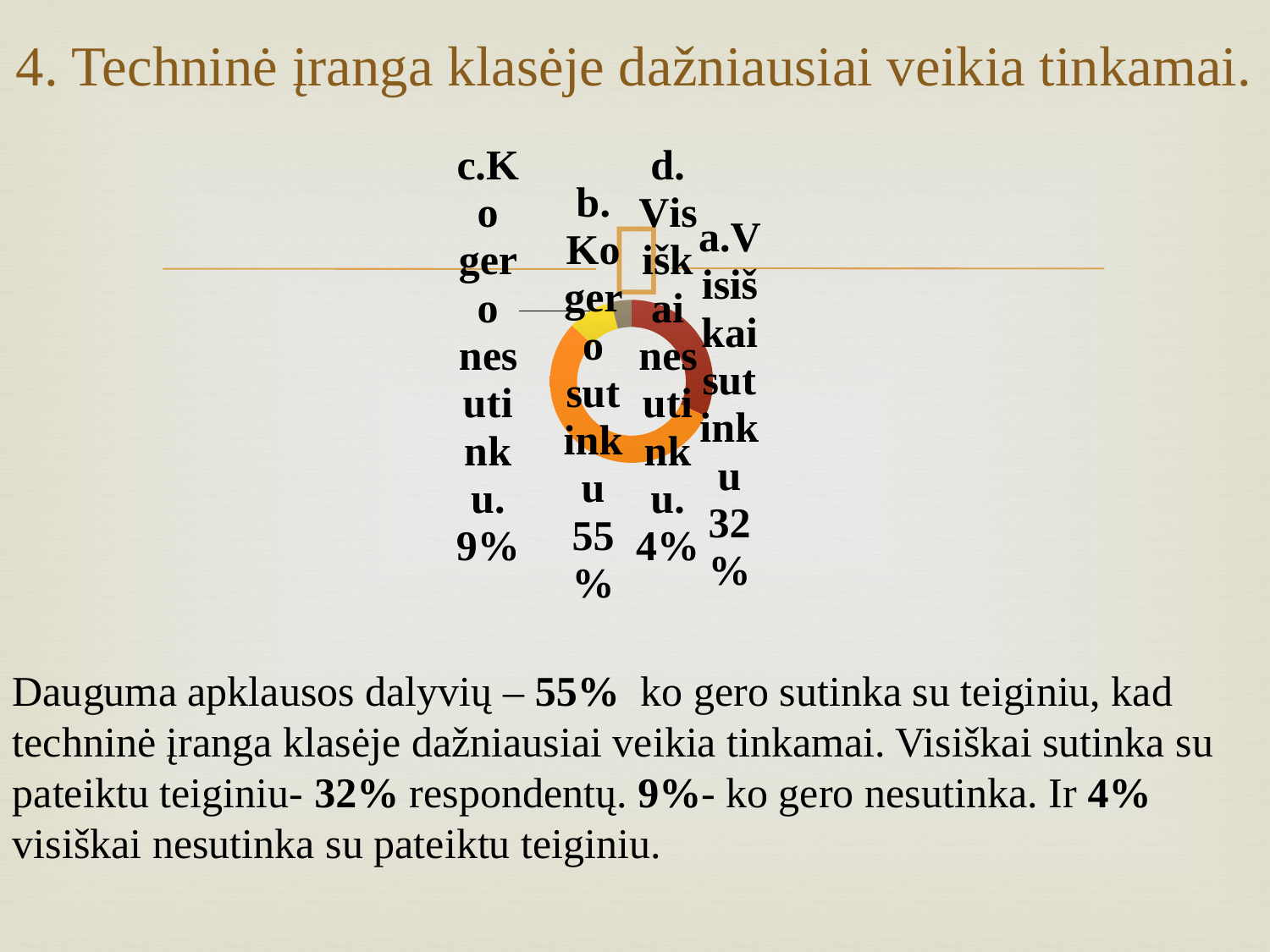
What is the difference in percentage points between "b. Ko gero sutinku" and "a. Visiškai sutinku"? 23 Which is larger: the share for "a. Visiškai sutinku" or the share for "c. Ko gero nesutinku"? a. Visiškai sutinku What percentage of respondents chose "c. Ko gero nesutinku"? 9% Which answer option has the smallest share in the chart? d. Visiškai nesutinku What is the combined share of respondents who agree ("a. Visiškai sutinku" and "b. Ko gero sutinku")? 87% How many answer categories are shown in the chart? 4 What percentage of respondents chose "d. Visiškai nesutinku"? 4% What is the difference in percentage points between "c. Ko gero nesutinku" and "d. Visiškai nesutinku"? 5 What percentage of respondents chose "a. Visiškai sutinku"? 32% What kind of chart is shown on the slide? Doughnut chart What percentage of respondents chose "b. Ko gero sutinku"? 55% Which answer option has the largest share in the chart? b. Ko gero sutinku